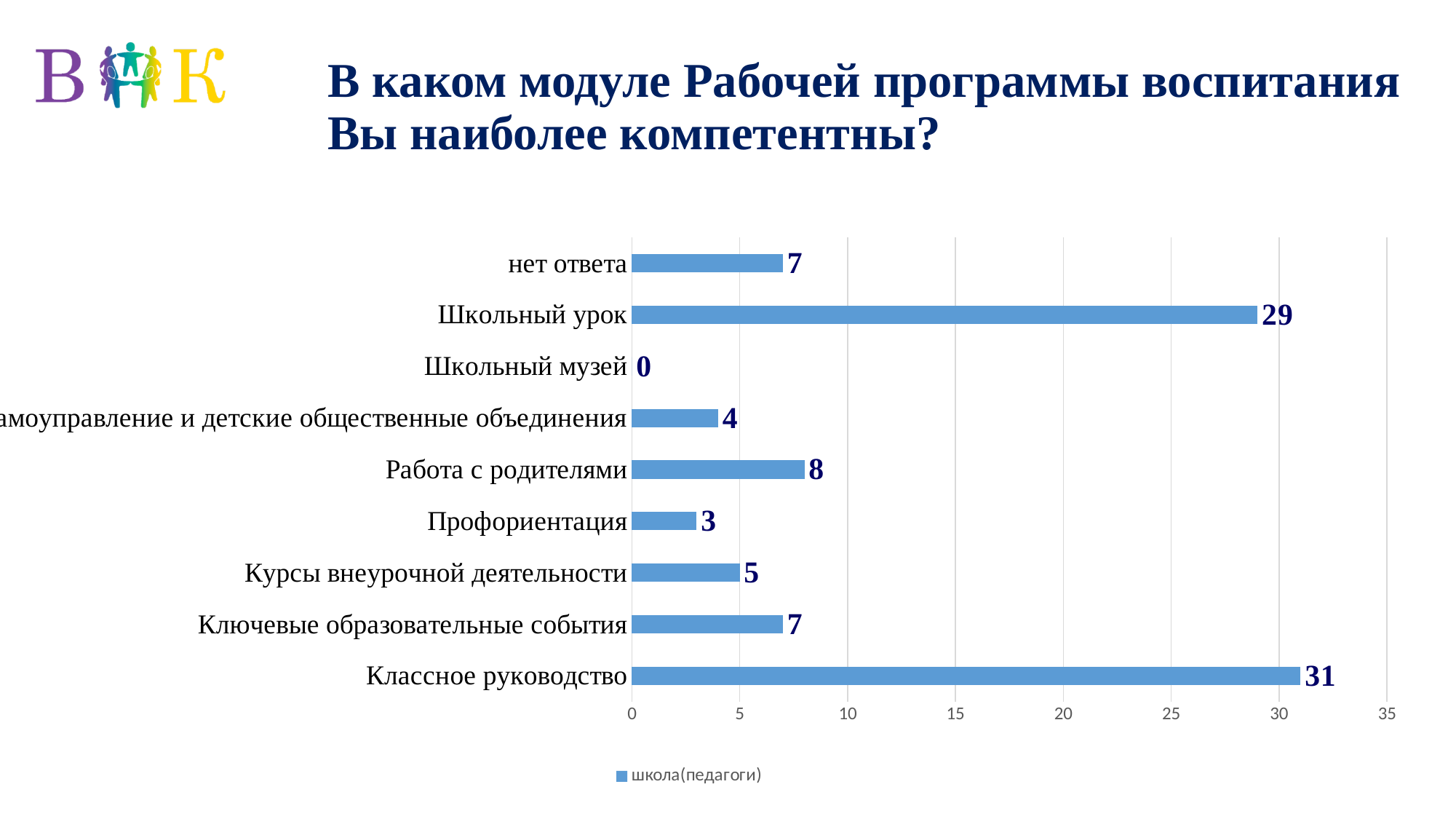
What is the value for Работа с родителями? 8 Which is larger, the value for Курсы внеурочной деятельности or the value for Ключевые образовательные события? Ключевые образовательные события What is the value for Профориентация? 3 What is the value for Школьный урок? 29 Which category has the lowest value? Школьный музей What is the value for Классное руководство? 31 How many series does the legend list? 1 What kind of chart is shown on the slide? bar chart How many categories are shown in the chart? 9 What is the difference between the values for Классное руководство and Школьный урок? 2 Which category has the highest value? Классное руководство What is the legend entry of the chart? школа(педагоги)